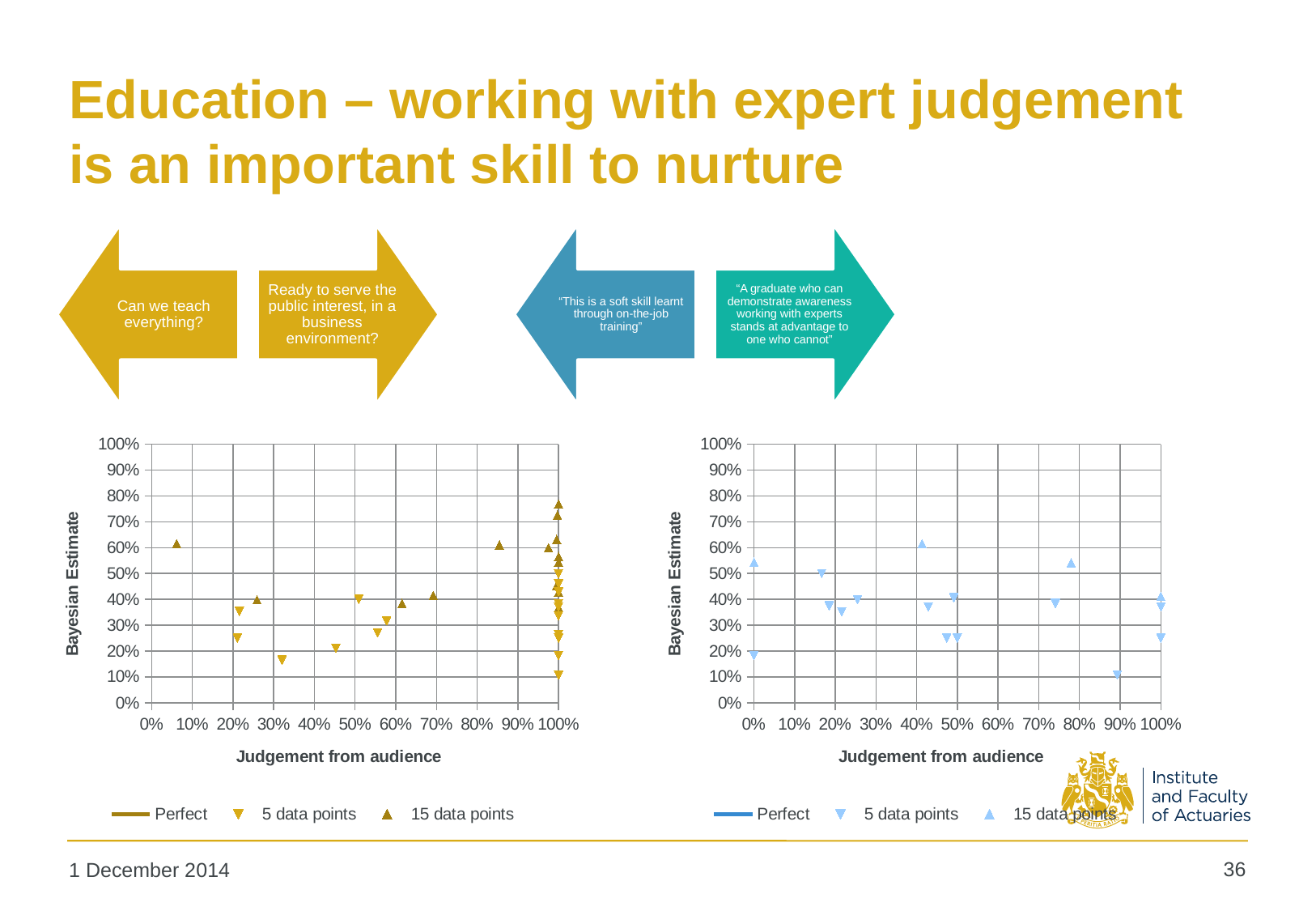
In the right chart, is the lowest Bayesian Estimate plotted greater or less than 20%? less What is the maximum value shown on the vertical axis of the left chart? 100% What kind of chart is the right chart on the slide? scatter chart In the left chart, is the lowest Bayesian Estimate plotted greater or less than 20%? less What kind of chart is the left chart on the slide? scatter chart What is the title of the vertical axis on the left chart? Bayesian Estimate How many series does the legend of the right chart list? 3 In the left chart, is the highest Bayesian Estimate plotted greater or less than 70%? greater What is the title of the horizontal axis on the right chart? Judgement from audience How many series does the legend of the left chart list? 3